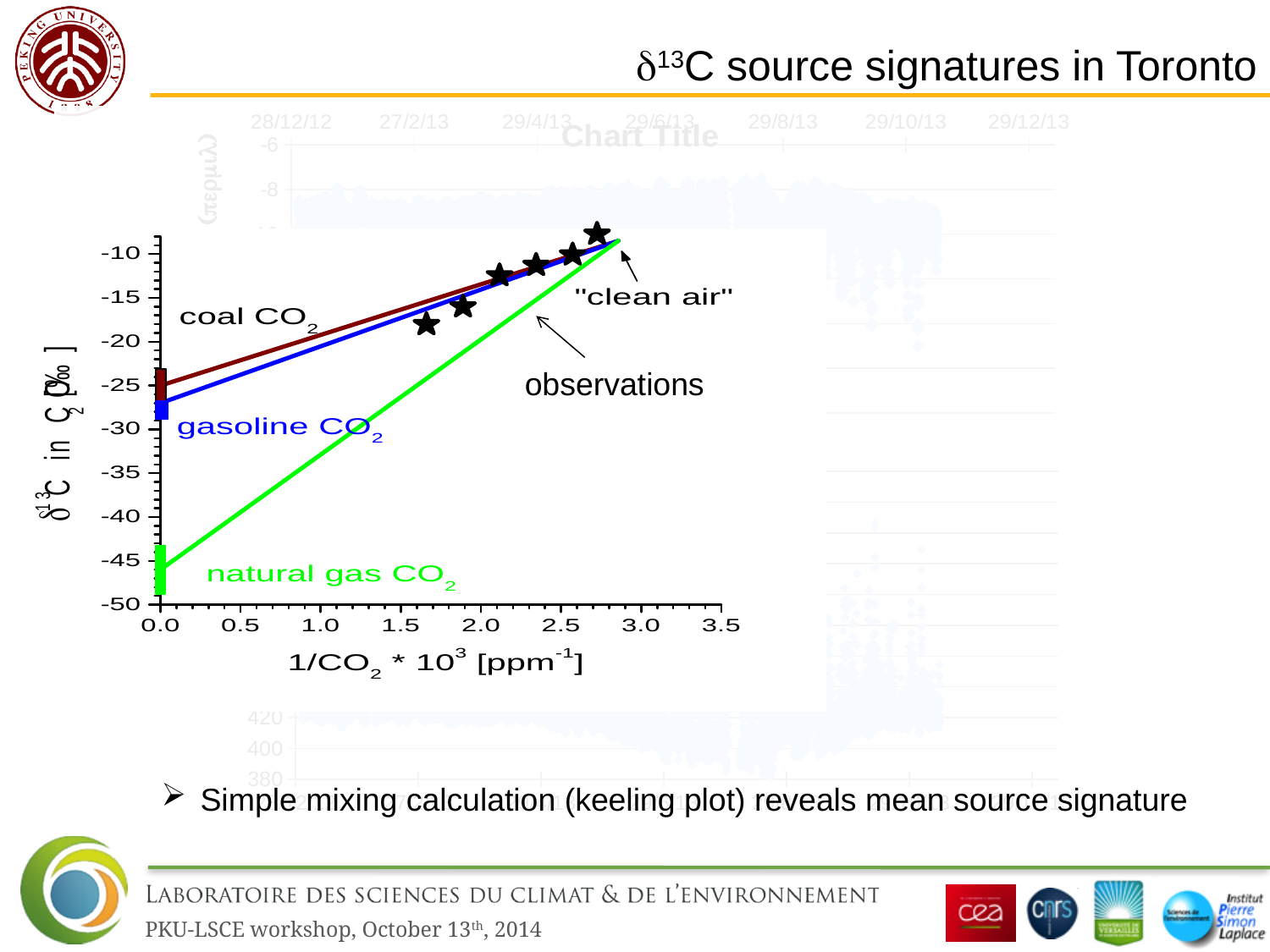
Which source line has the lowest δ13C value at 1/CO2 = 0.0? natural gas CO2 Which line has a higher δ13C intercept at 1/CO2 = 0.0, coal CO2 or gasoline CO2? coal CO2 Is the δ13C intercept of the coal CO2 line at 1/CO2 = 0.0 greater or less than -30? greater Is the δ13C intercept of the gasoline CO2 line at 1/CO2 = 0.0 greater or less than -25? less Is the δ13C intercept of the natural gas CO2 line at 1/CO2 = 0.0 greater or less than -40? less How many observation points (stars) are plotted on the chart? 6 Do the observation points rise or fall as 1/CO2 increases along the x axis? rise How many source lines are drawn on the chart? 3 What kind of chart is shown on the slide? line chart What colour is the natural gas CO2 line? green What label is given to the point where the three lines converge at the upper right? "clean air" Which source line has the highest δ13C value at 1/CO2 = 0.0? coal CO2